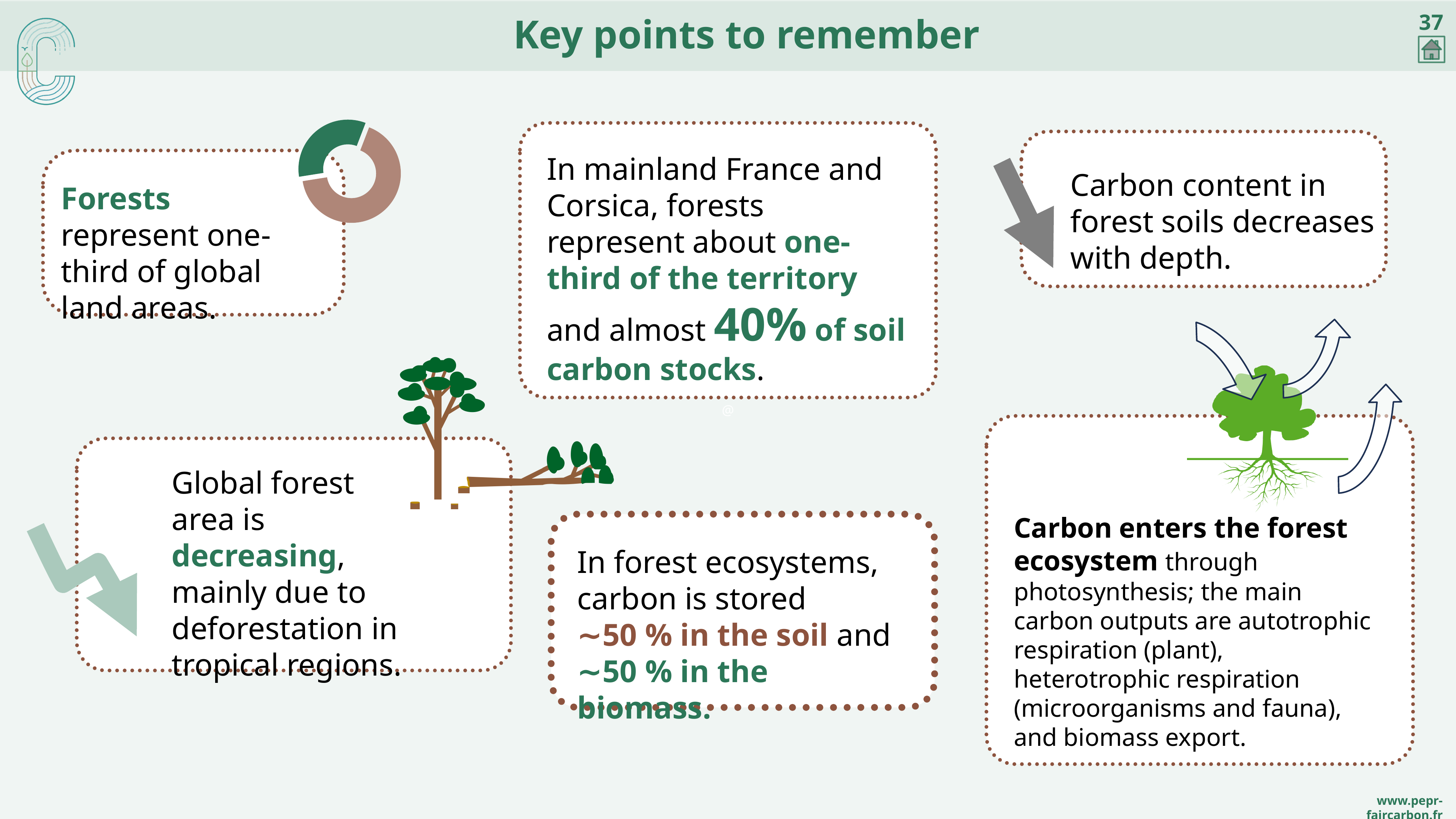
According to the slide, what share of global land areas do forests represent, as illustrated by the doughnut chart? one-third In the doughnut chart next to the 'Forests' box, which slice is larger, the green one or the brown one? the brown one In the doughnut chart next to the 'Forests' box, which slice is smaller, the green one or the brown one? the green one What colour is the smaller slice of the doughnut chart next to the 'Forests' box? green Does the doughnut chart next to the 'Forests' box have a legend? No How many slices does the doughnut chart next to the 'Forests' box have? 2 What kind of chart is shown next to the 'Forests represent one-third of global land areas' box? doughnut chart